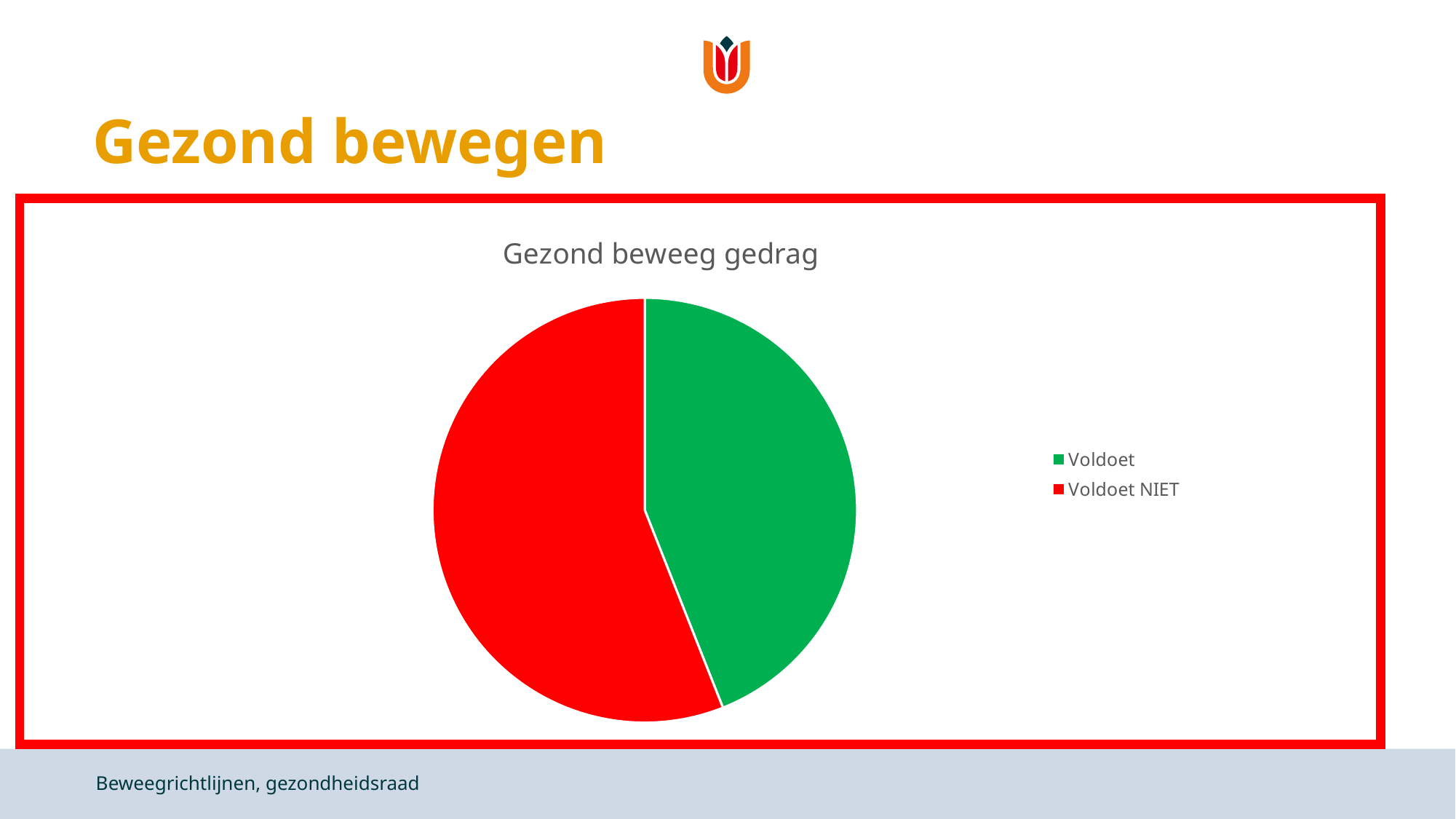
Which category has the smallest slice of the pie? Voldoet Is the Voldoet slice more or less than half of the pie? less What kind of chart is shown on the slide? pie chart How many entries does the legend list? 2 Which category has the largest slice of the pie? Voldoet NIET How many slices does the pie chart have? 2 Is the Voldoet NIET slice more or less than half of the pie? more Which slice is larger, Voldoet or Voldoet NIET? Voldoet NIET What colour is the Voldoet slice? green What is the title of the chart? Gezond beweeg gedrag